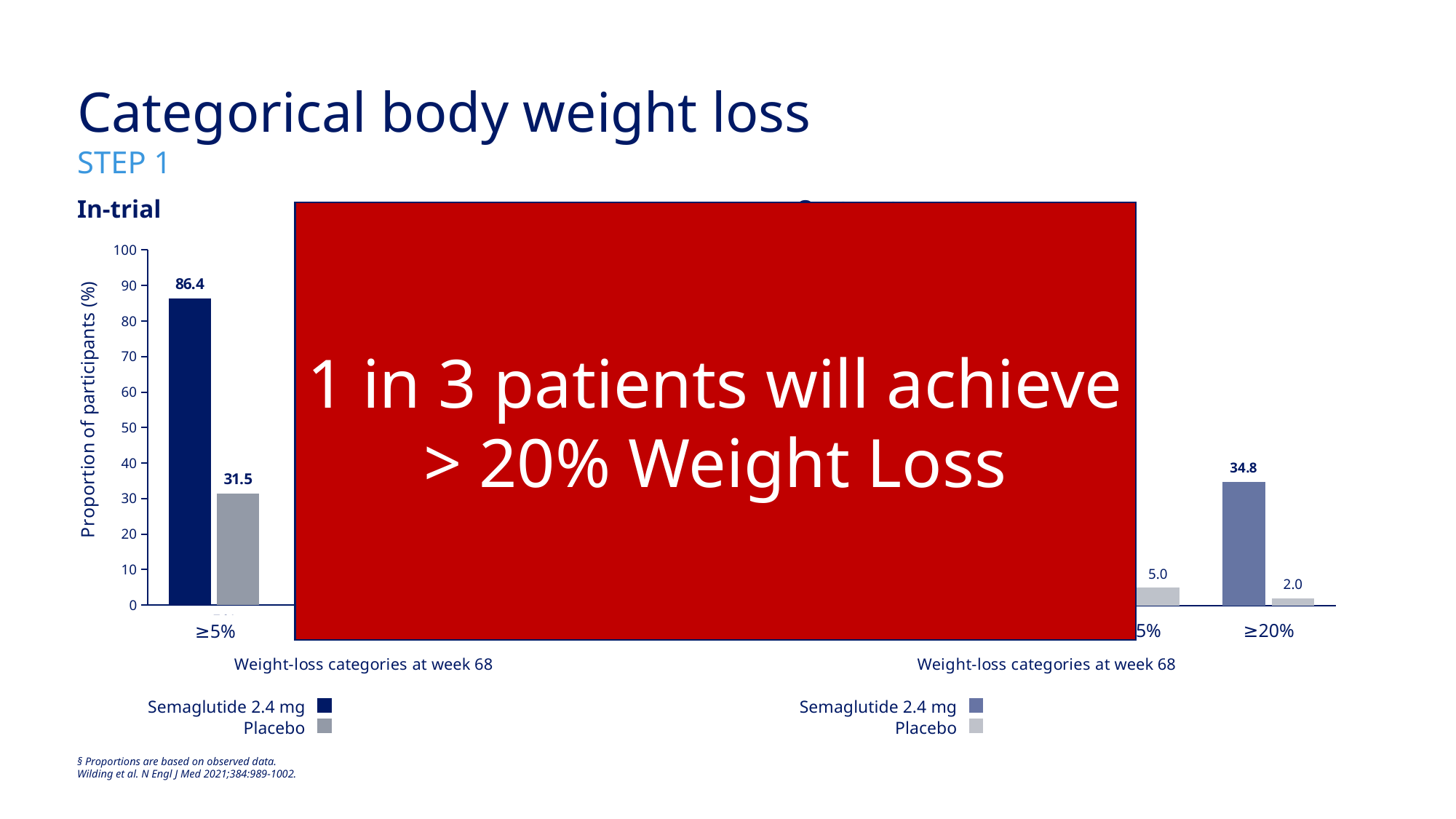
In the right chart, what is the difference between the Semaglutide 2.4 mg and Placebo values in the ≥20% category? 32.8 How many series does the legend of the left chart (In-trial) list? 2 In the right chart, what is the value for Semaglutide 2.4 mg in the ≥20% weight-loss category? 34.8 In the right chart, what is the value for Placebo in the ≥20% weight-loss category? 2.0 What is the y-axis label of the left chart (In-trial)? Proportion of participants (%) In the left chart (In-trial), what is the value for Placebo in the ≥5% weight-loss category? 31.5 In the left chart (In-trial), what is the difference between the Semaglutide 2.4 mg and Placebo values in the ≥5% category? 54.9 What kind of chart is the left chart (In-trial)? bar chart In the left chart (In-trial), which is larger in the ≥5% category, Semaglutide 2.4 mg or Placebo? Semaglutide 2.4 mg In the left chart (In-trial), is the Placebo value for the ≥5% category greater or less than 40? less In the left chart (In-trial), what is the value for Semaglutide 2.4 mg in the ≥5% weight-loss category? 86.4 In the right chart, which is larger in the ≥20% category, Semaglutide 2.4 mg or Placebo? Semaglutide 2.4 mg